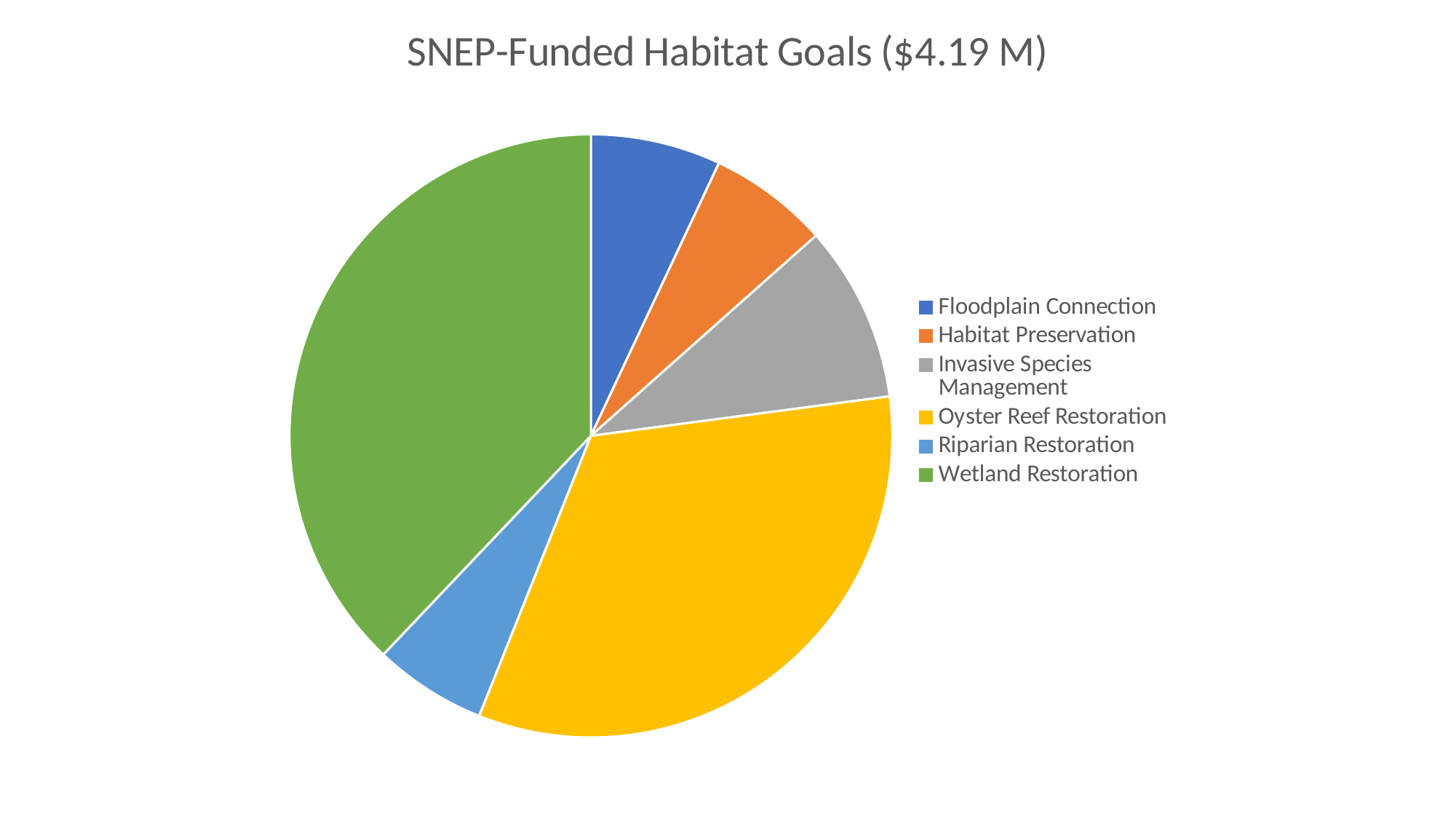
What kind of chart is shown on the slide? pie chart Which category is shown in yellow on the pie chart? Oyster Reef Restoration Which slice is larger, Invasive Species Management or Floodplain Connection? Invasive Species Management Which slice is larger, Oyster Reef Restoration or Invasive Species Management? Oyster Reef Restoration Which category has the largest slice of the pie? Wetland Restoration What is the title of the chart? SNEP-Funded Habitat Goals ($4.19 M) Which slice is larger, Wetland Restoration or Riparian Restoration? Wetland Restoration How many slices does the pie chart have? 6 What total funding amount is given in the chart title? $4.19 M